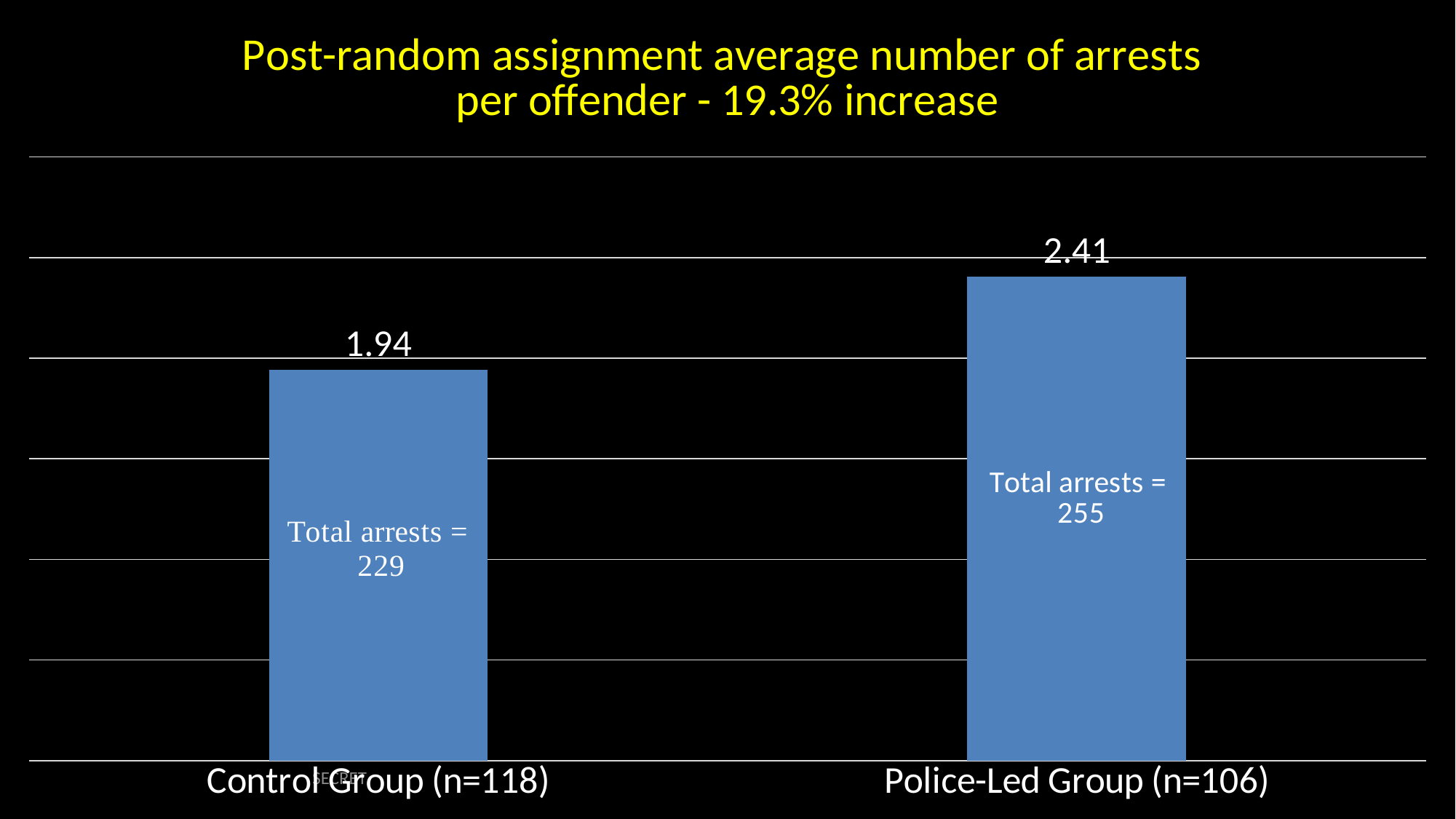
What is the total number of arrests shown for the Control Group? 229 What is the average number of arrests per offender for the Control Group (n=118)? 1.94 What is the average number of arrests per offender for the Police-Led Group (n=106)? 2.41 What kind of chart is shown on the slide? Bar chart Is the average number of arrests per offender larger for the Control Group or the Police-Led Group? Police-Led Group What is the total number of arrests shown for the Police-Led Group? 255 What is the difference in total arrests between the Police-Led Group and the Control Group? 26 Which group has the higher average number of arrests per offender? Police-Led Group (n=106) What percentage increase is stated in the chart title? 19.3% What is the difference between the average number of arrests per offender for the Police-Led Group and the Control Group? 0.47 How many groups are shown in the chart? 2 Which group has the lower average number of arrests per offender? Control Group (n=118)